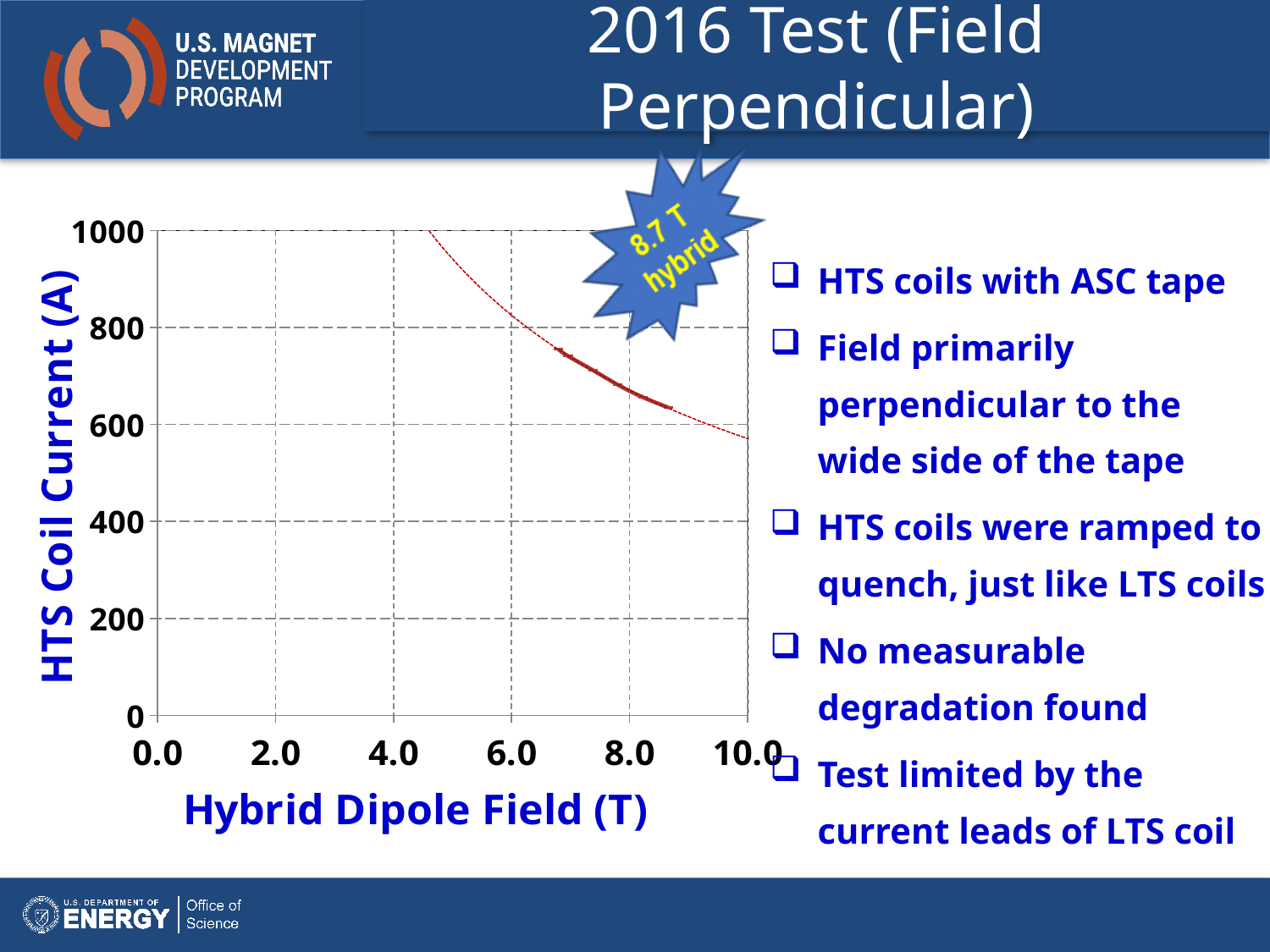
What is the label of the horizontal axis of the chart? Hybrid Dipole Field (T) Is the HTS coil current at a hybrid dipole field of 7.0 T greater or less than 800 A? less What kind of chart is shown on the slide? line chart Is the HTS coil current at a hybrid dipole field of 7.0 T greater or less than 600 A? greater Does the HTS coil current rise or fall as the hybrid dipole field increases? fall What is the maximum value shown on the vertical axis of the chart? 1000 Is the HTS coil current at a hybrid dipole field of 5.0 T greater or less than 800 A? greater What hybrid field value is highlighted in the starburst callout on the chart? 8.7 T What is the label of the vertical axis of the chart? HTS Coil Current (A) Is the HTS coil current higher at a hybrid dipole field of 7.0 T or at 8.0 T? 7.0 T